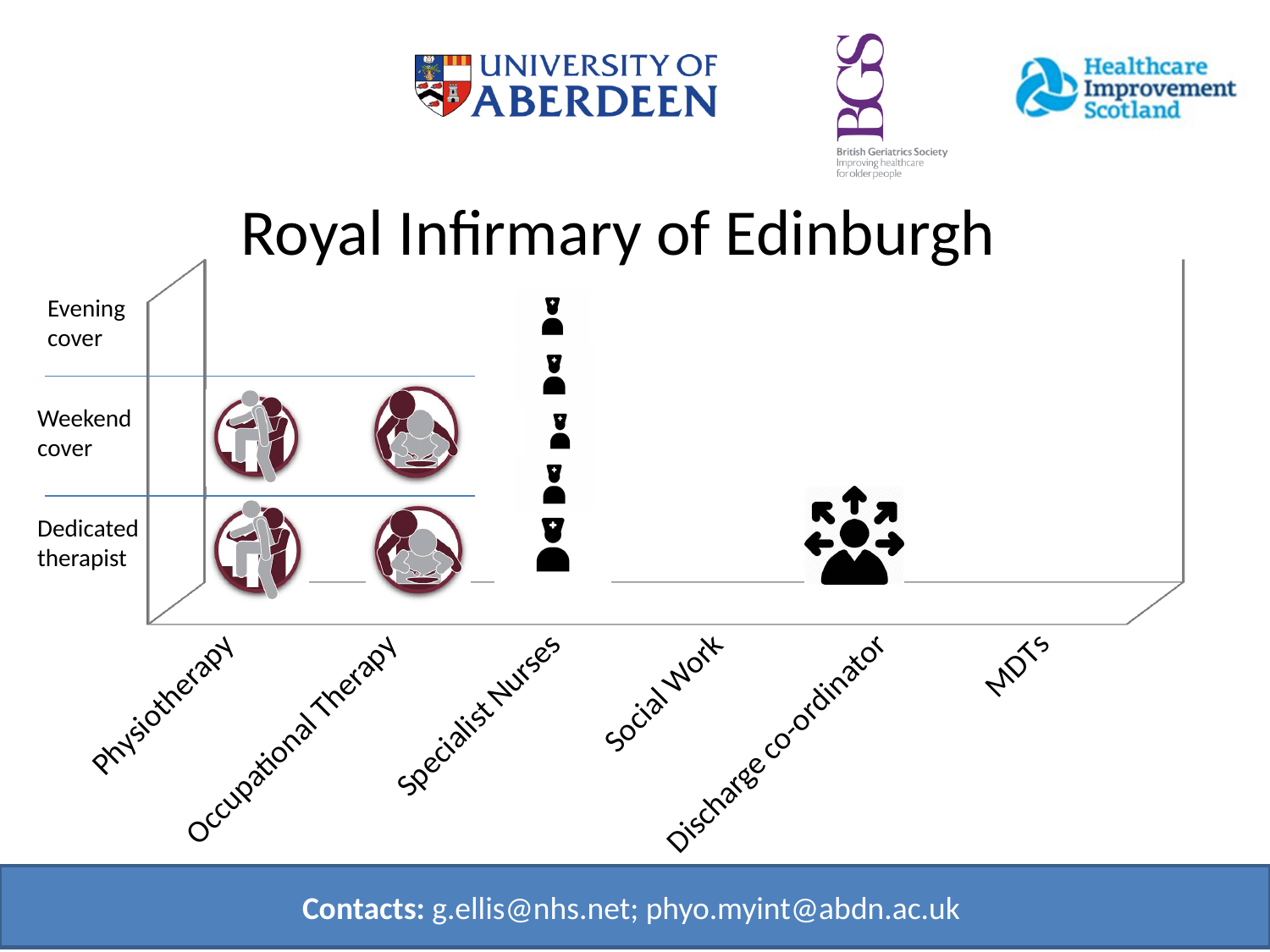
How many levels of cover are labelled on the y axis of the chart? 3 Which reaches a higher level of cover on the chart, Physiotherapy or Discharge co-ordinator? Physiotherapy What is the highest level of cover reached by Discharge co-ordinator on the chart? Dedicated therapist What is the label of the lowest level on the y axis of the chart? Dedicated therapist Which reaches a higher level of cover on the chart, Specialist Nurses or Occupational Therapy? Specialist Nurses What is the highest level of cover reached by Physiotherapy on the chart? Weekend cover What is the title of the chart? Royal Infirmary of Edinburgh What is the highest level of cover reached by Occupational Therapy on the chart? Weekend cover Which categories have no icons plotted at all on the chart? Social Work and MDTs How many categories are shown along the x axis of the chart? 6 Which category reaches the highest level (Evening cover) on the chart? Specialist Nurses What kind of chart is shown on the slide? Bar chart (pictogram with icons)